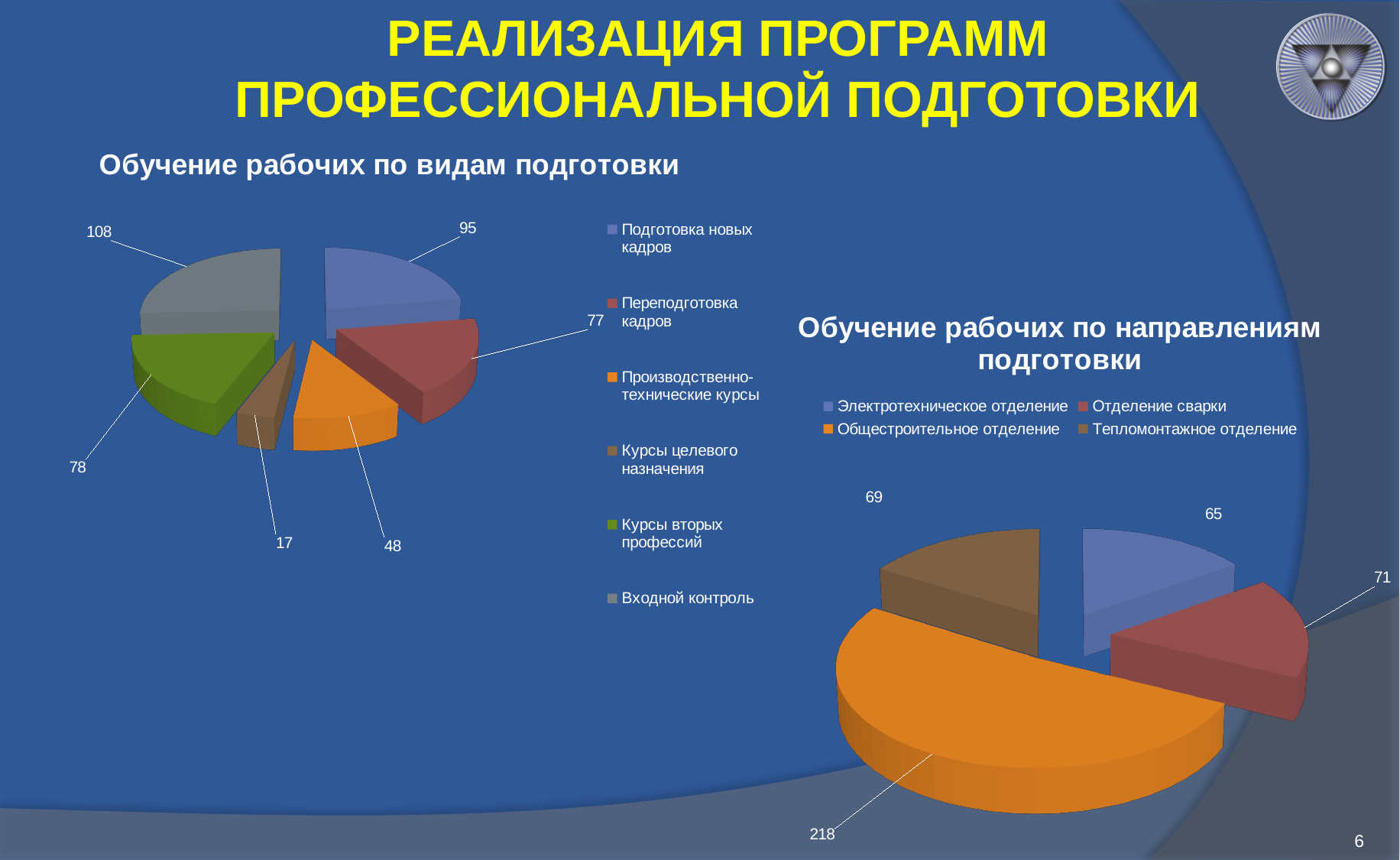
In the chart 'Обучение рабочих по направлениям подготовки', what is the value for 'Отделение сварки'? 71 In the chart 'Обучение рабочих по видам подготовки', what is the difference between 'Входной контроль' and 'Переподготовка кадров'? 31 What type of chart is 'Обучение рабочих по направлениям подготовки'? Pie chart In the chart 'Обучение рабочих по видам подготовки', how many categories are shown? 6 In the chart 'Обучение рабочих по видам подготовки', which category has the largest value? Входной контроль In the chart 'Обучение рабочих по направлениям подготовки', what is the difference between 'Общестроительное отделение' and 'Электротехническое отделение'? 153 In the chart 'Обучение рабочих по направлениям подготовки', which category has the smallest value? Электротехническое отделение In the chart 'Обучение рабочих по видам подготовки', which category has the smallest value? Курсы целевого назначения In the chart 'Обучение рабочих по направлениям подготовки', which is larger: 'Отделение сварки' or 'Тепломонтажное отделение'? Отделение сварки In the chart 'Обучение рабочих по видам подготовки', what is the value for 'Курсы целевого назначения'? 17 In the chart 'Обучение рабочих по видам подготовки', what is the value for 'Подготовка новых кадров'? 95 In the chart 'Обучение рабочих по направлениям подготовки', what is the value for 'Общестроительное отделение'? 218